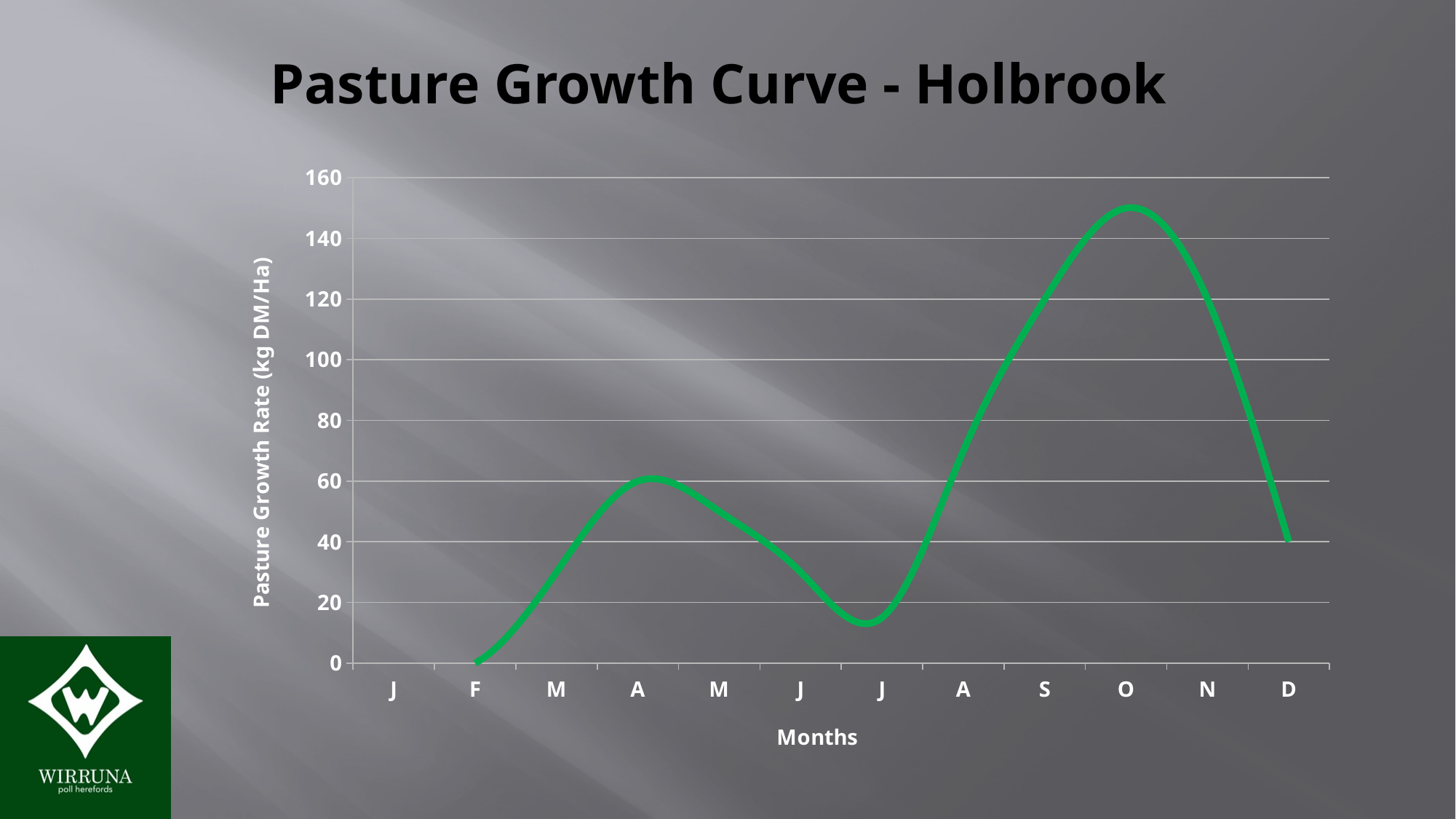
Is the value for October (O) greater or less than 140? greater How many months are labelled along the x axis? 12 What is the label on the vertical axis? Pasture Growth Rate (kg DM/Ha) What kind of chart is shown on the slide? line chart What is the pasture growth rate in February (F), where the line begins? 0 Is the value for April (A) greater or less than 40? greater What is the pasture growth rate in December (D), where the line ends? 40 In which month does the pasture growth rate reach its highest point? O Is the value for July (the second J) greater or less than 20? less Which month has the higher pasture growth rate, April (A) or October (O)? O Does the pasture growth rate rise or fall from October (O) to December (D)? fall What is the title of the chart? Pasture Growth Curve - Holbrook